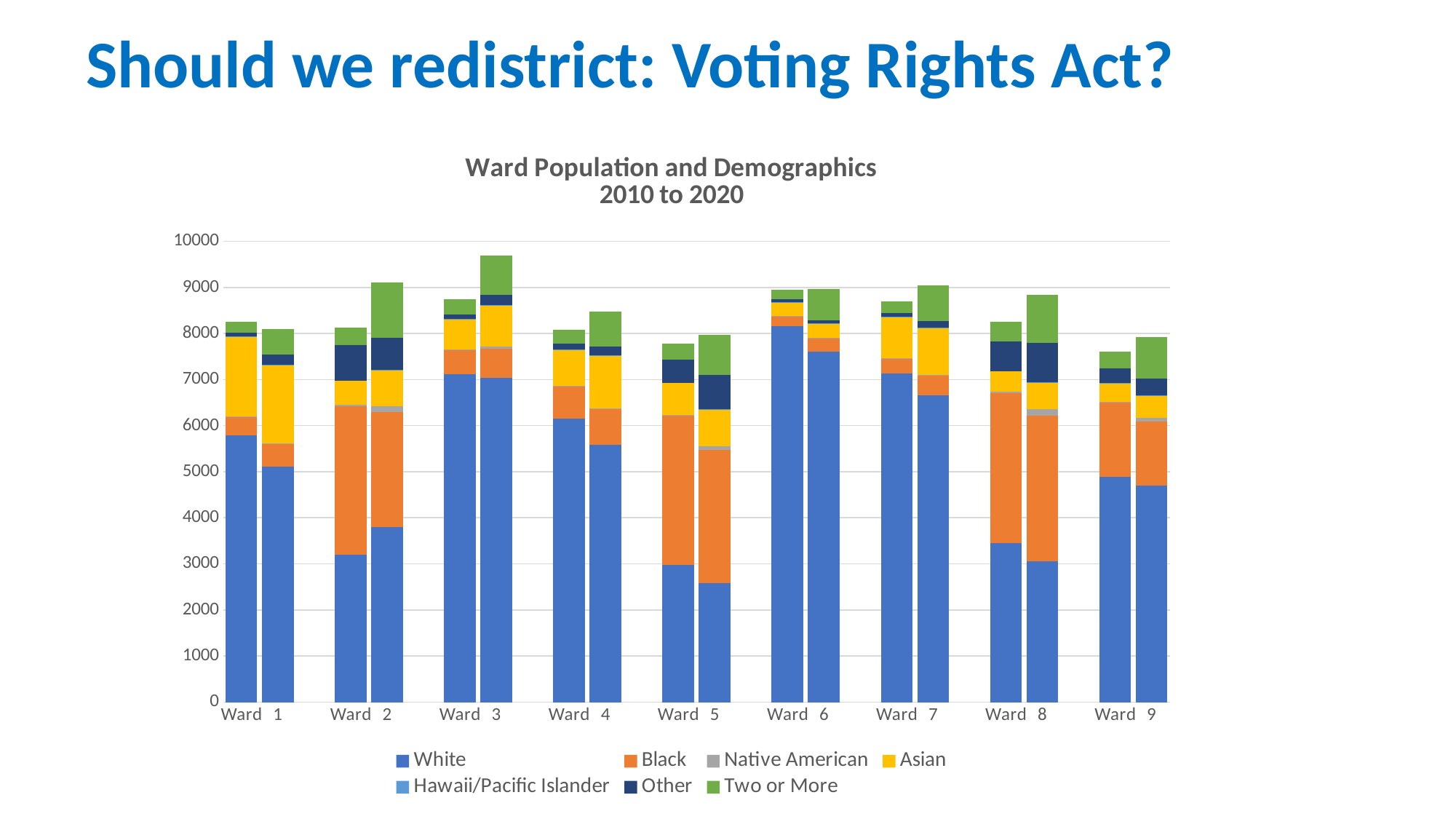
Is the total of the right bar for Ward 9 greater or less than 7000? greater Is the White segment of the left bar for Ward 6 greater or less than 8000? greater How many series does the chart's legend list? 7 What kind of chart is shown on the slide? Stacked bar chart Which colour represents the Black series in the chart's legend? Orange Is the White segment of the left bar for Ward 2 greater or less than 4000? less What is the title of the chart? Ward Population and Demographics 2010 to 2020 Which has the larger White segment in its left bar: Ward 6 or Ward 2? Ward 6 Which ward has the tallest stacked bar in the chart? Ward 3 How many wards are shown along the x axis of the chart? 9